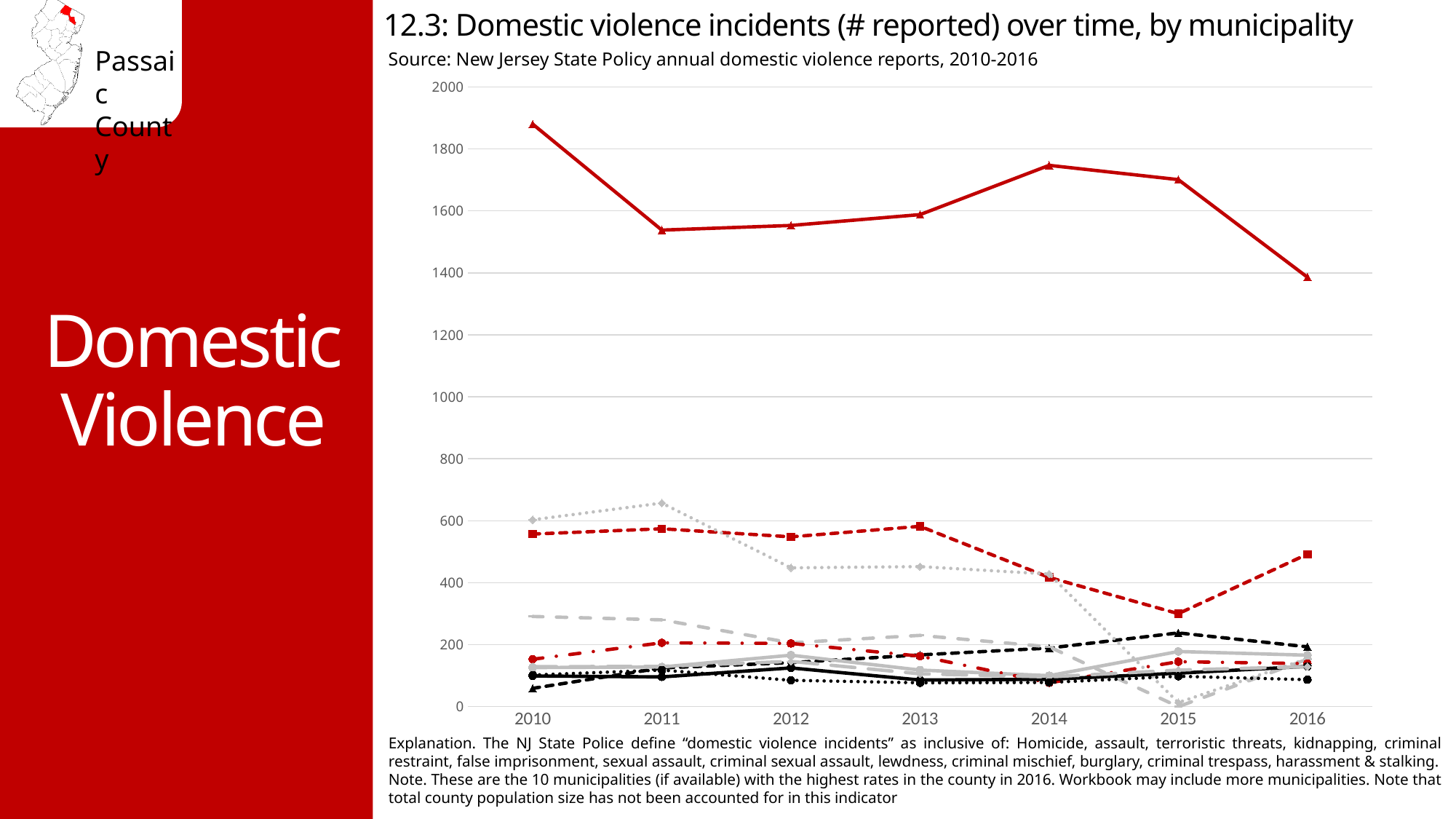
Is the value of the topmost solid red line in 2011 greater or less than 1600? less What is the last year shown on the x axis? 2016 Is the value of the topmost solid red line in 2014 greater or less than 1600? greater In which year does the topmost solid red line reach its lowest value? 2016 What is the first year shown on the x axis? 2010 Does the topmost solid red line rise or fall between 2010 and 2011? fall How many years are plotted along the x axis? 7 Does the topmost solid red line rise or fall between 2015 and 2016? fall In which year does the topmost solid red line reach its highest value? 2010 Is the value of the topmost solid red line in 2014 larger or smaller than its value in 2016? larger What kind of chart is shown on the slide? line chart Is the value of the topmost solid red line in 2010 greater or less than 1800? greater